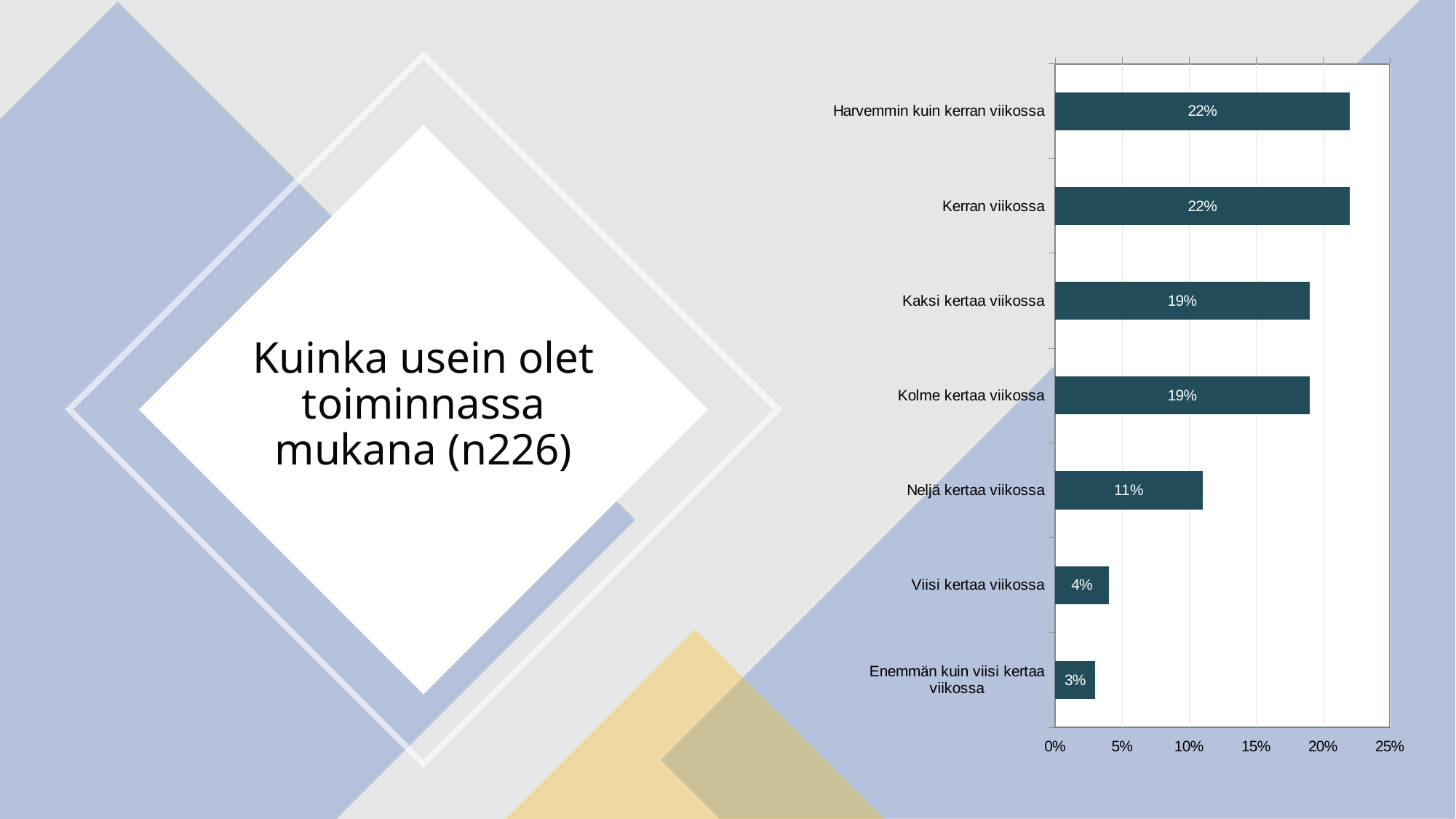
What type of chart is shown on the slide? bar chart Which is larger, the value for Kaksi kertaa viikossa or the value for Neljä kertaa viikossa? Kaksi kertaa viikossa Is the value for Harvemmin kuin kerran viikossa greater or less than 20%? greater What is the value for Kaksi kertaa viikossa? 19% What is the value for Viisi kertaa viikossa? 4% What is the difference between the values for Kerran viikossa and Neljä kertaa viikossa? 11% What is the maximum value shown on the horizontal axis? 25% What is the value for Enemmän kuin viisi kertaa viikossa? 3% What is the value for Neljä kertaa viikossa? 11% What is the difference between the values for Kolme kertaa viikossa and Viisi kertaa viikossa? 15% How many categories are shown in the chart? 7 Which category has the lowest value? Enemmän kuin viisi kertaa viikossa